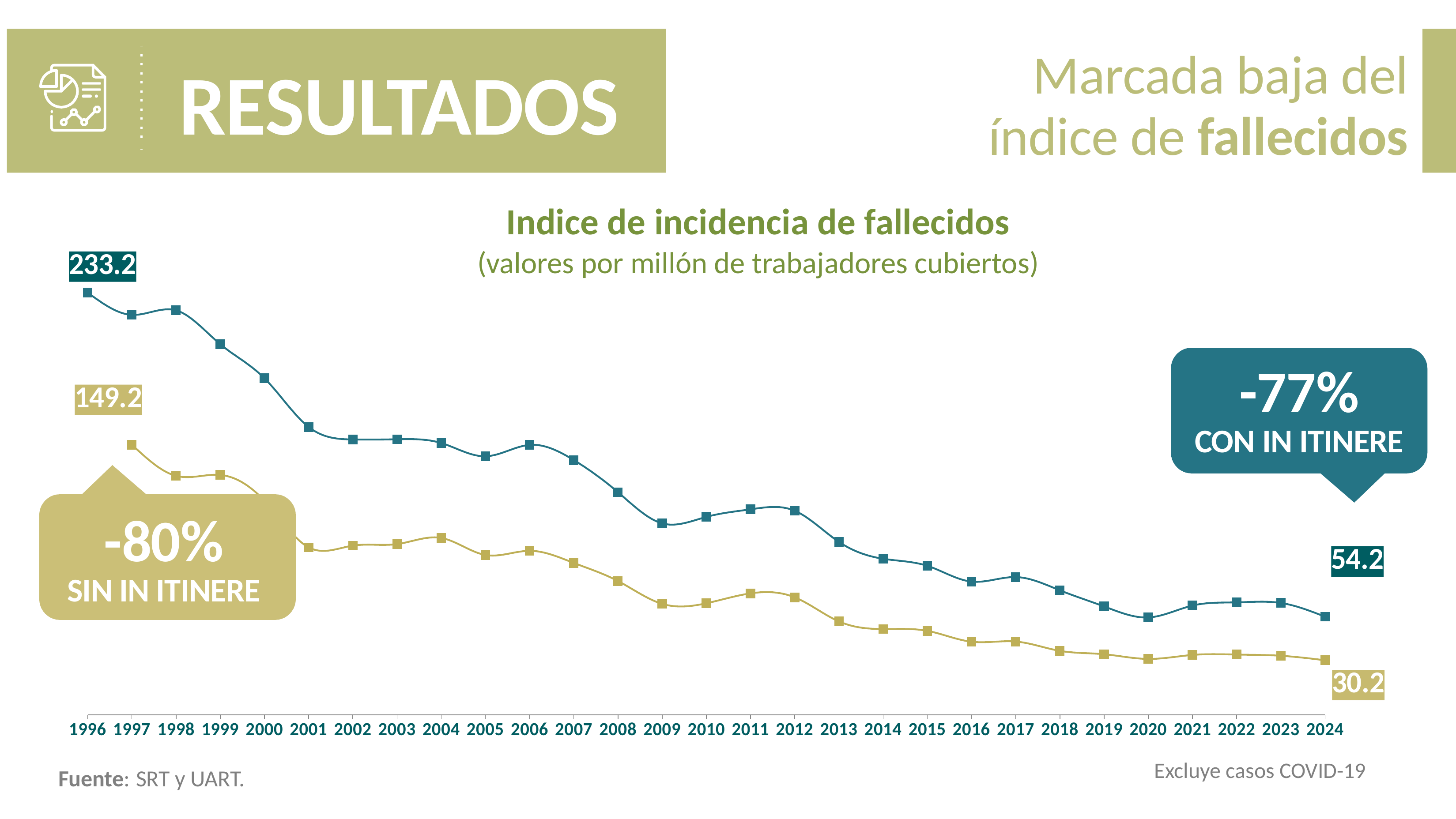
What is the difference between the CON IN ITINERE values in 1996 and 2024? 179.0 How many years are shown on the x axis? 29 What is the first labelled value of the SIN IN ITINERE series? 149.2 What percentage change is shown in the callout for the CON IN ITINERE series? -77% In 2024, which series has the higher value, CON IN ITINERE or SIN IN ITINERE? CON IN ITINERE Do the values of the CON IN ITINERE series generally rise or fall from 1996 to 2024? fall In which year does the CON IN ITINERE series reach its highest value? 1996 In 2024, what is the difference between the CON IN ITINERE and SIN IN ITINERE values? 24.0 What is the value of the CON IN ITINERE series in 2024? 54.2 What is the value of the CON IN ITINERE series in 1996? 233.2 What kind of chart is shown on the slide? line chart What is the value of the SIN IN ITINERE series in 2024? 30.2